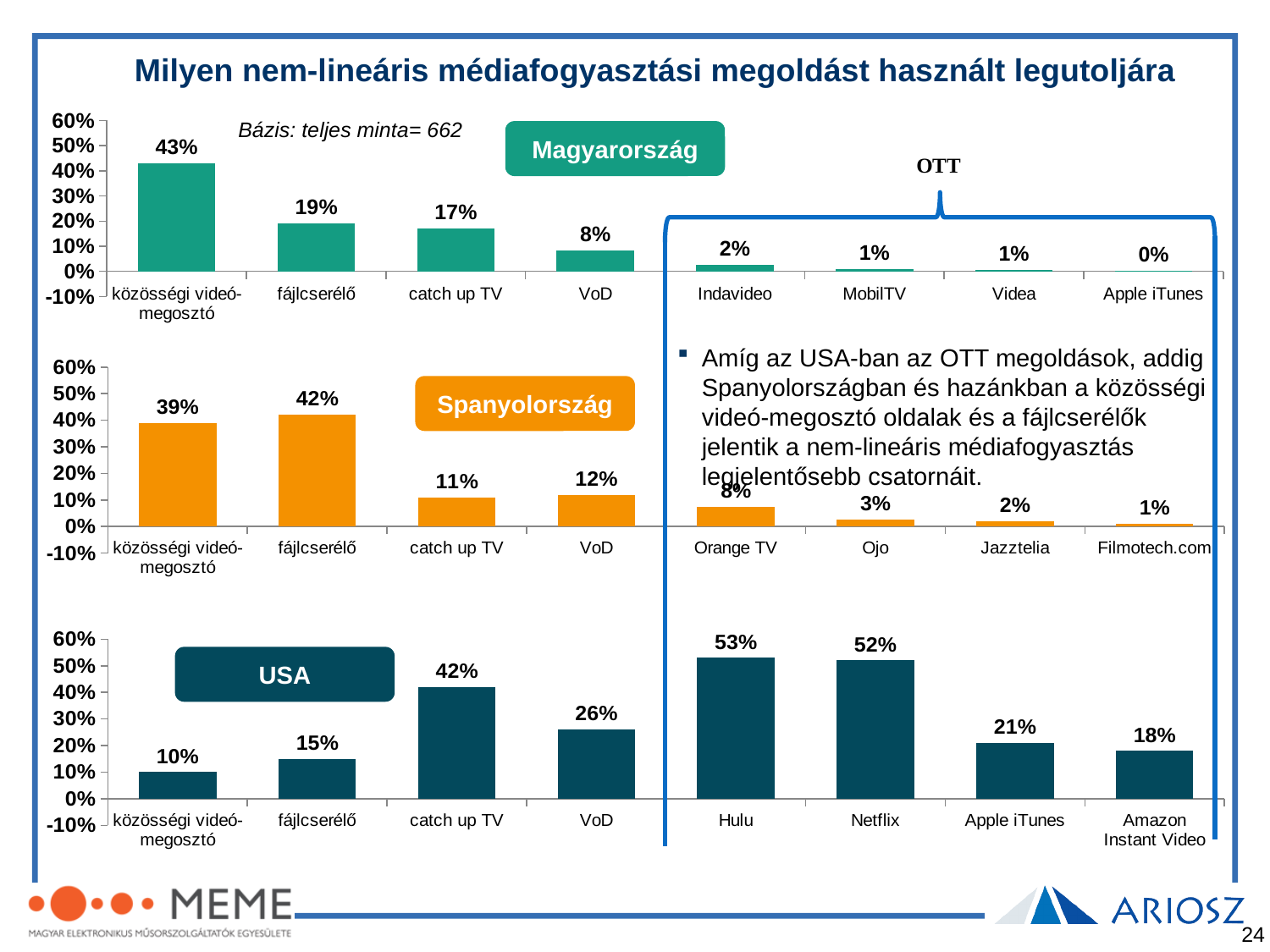
What type of chart is the Spanyolország chart? bar chart In the Magyarország chart, what is the value for közösségi videó-megosztó? 43% In the Spanyolország chart, what is the difference between fájlcserélő and közösségi videó-megosztó? 3% In the Spanyolország chart, what is the value for fájlcserélő? 42% In the USA chart, what is the difference between Apple iTunes and Amazon Instant Video? 3% In the Spanyolország chart, what is the value for Orange TV? 8% In the Magyarország chart, which category has the highest value? közösségi videó-megosztó In the USA chart, which is larger, catch up TV or VoD? catch up TV In the USA chart, which category has the highest value? Hulu In the USA chart, what is the value for Netflix? 52% How many categories are shown in the USA chart? 8 In the Magyarország chart, what is the value for Apple iTunes? 0%